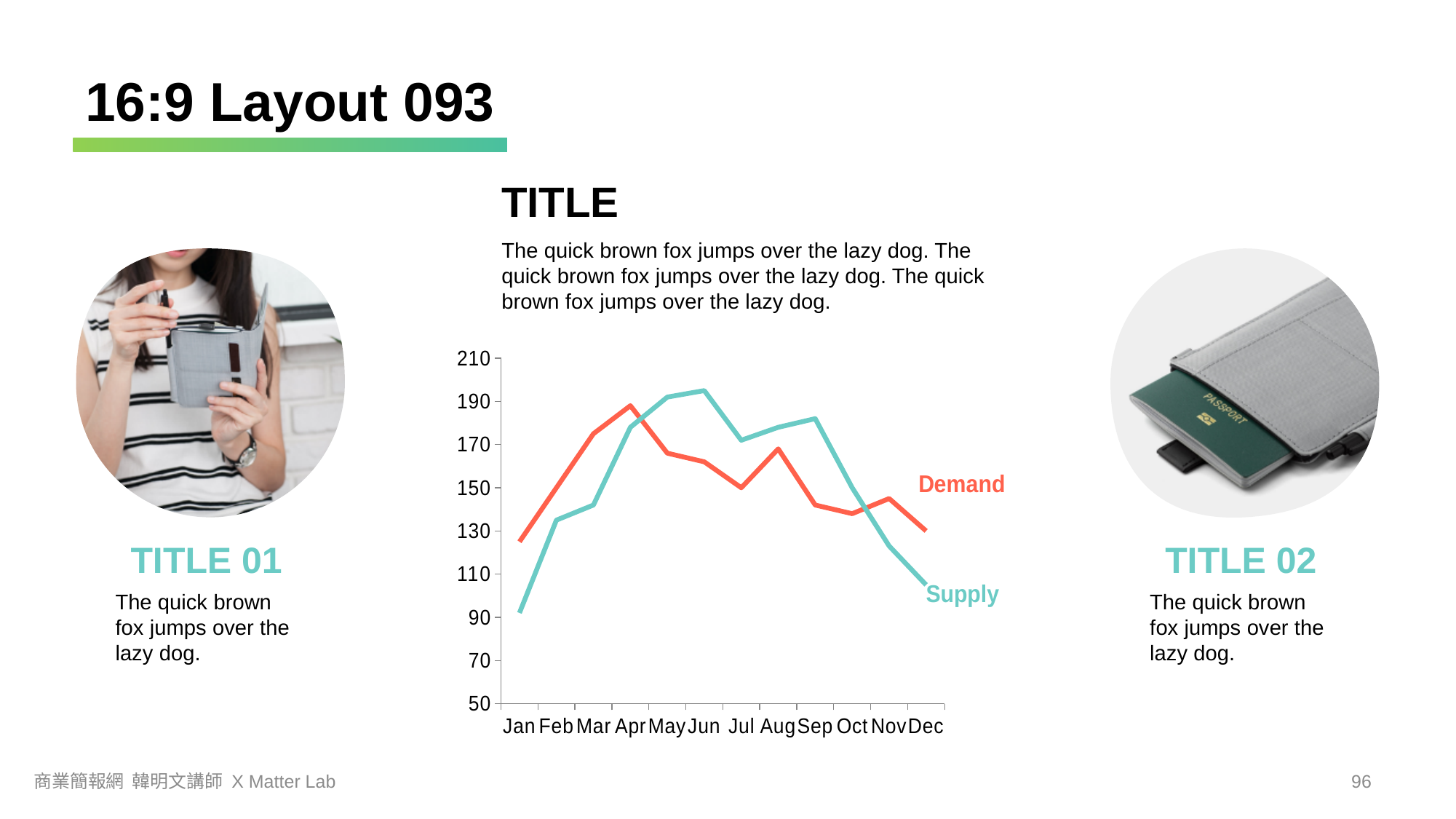
In which month is the Demand line at its highest? Apr What colour is the Demand line in the chart? red How many months are shown on the x axis of the chart? 12 Is the Demand value for Apr greater or less than 170? greater In Sep, which is larger, Demand or Supply? Supply Is the Supply value for Jun greater or less than 170? greater What kind of chart is shown on the slide? line chart How many series are plotted in the chart? 2 Does the Supply line rise or fall from Sep to Dec? fall In which month is the Supply line at its lowest? Jan Is the Supply value for Jan greater or less than 110? less In Jan, which is larger, Demand or Supply? Demand